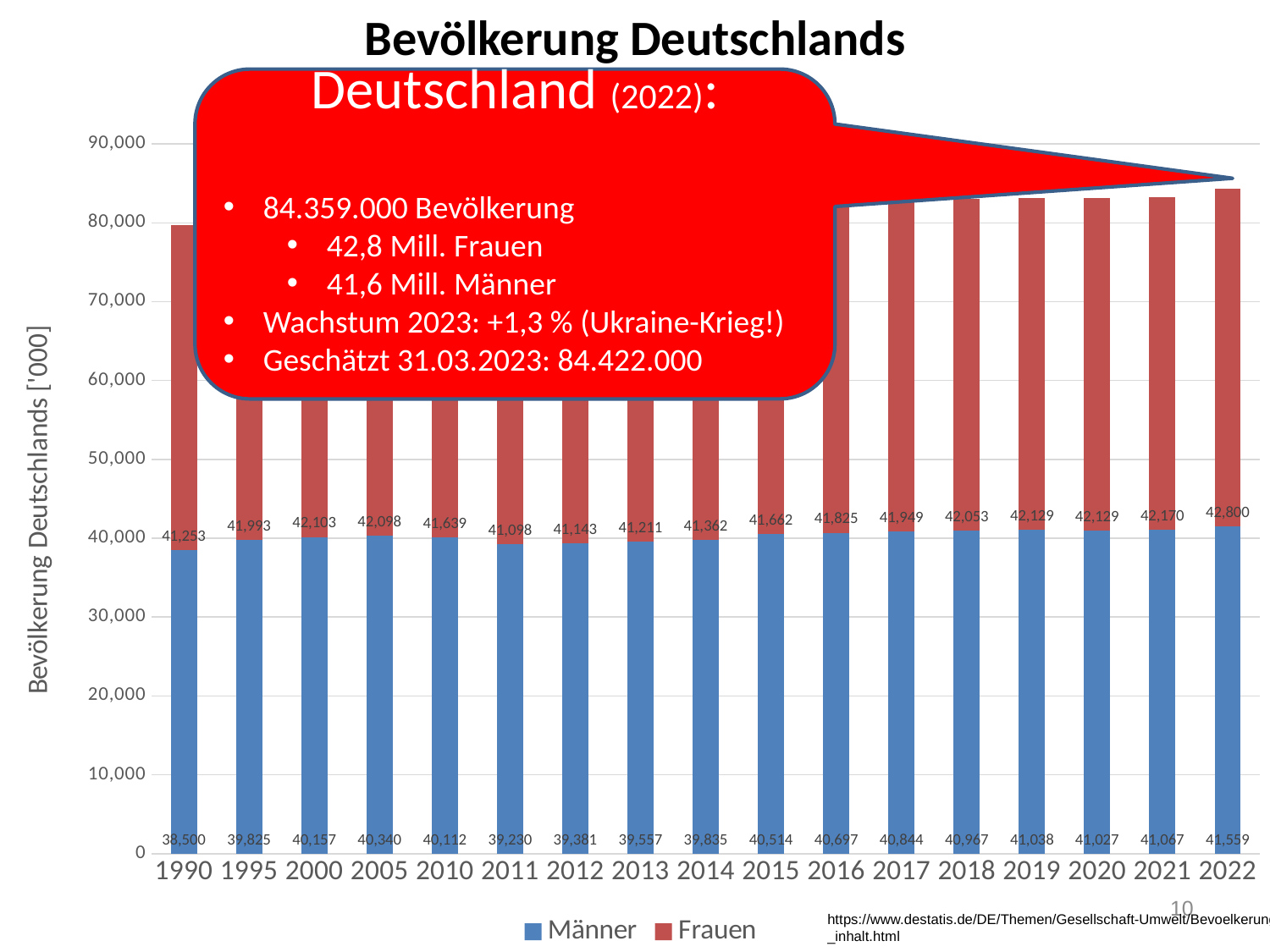
Is the total of the stacked bar for 2016 greater or less than 80,000? greater In which year is the Männer value lowest? 1990 What is the Männer value for 2011? 39,230 How many series does the legend list? 2 What is the total of the stacked bar for 2022? 84,359 What is the difference between the Frauen and Männer values in 2022? 1,241 What is the Männer value for 2022? 41,559 What is the Frauen value for 1990? 41,253 How many years are shown on the x axis? 17 In which year is the Frauen value highest? 2022 Which is larger in 2005, the Männer value or the Frauen value? Frauen What kind of chart is shown? Stacked bar chart